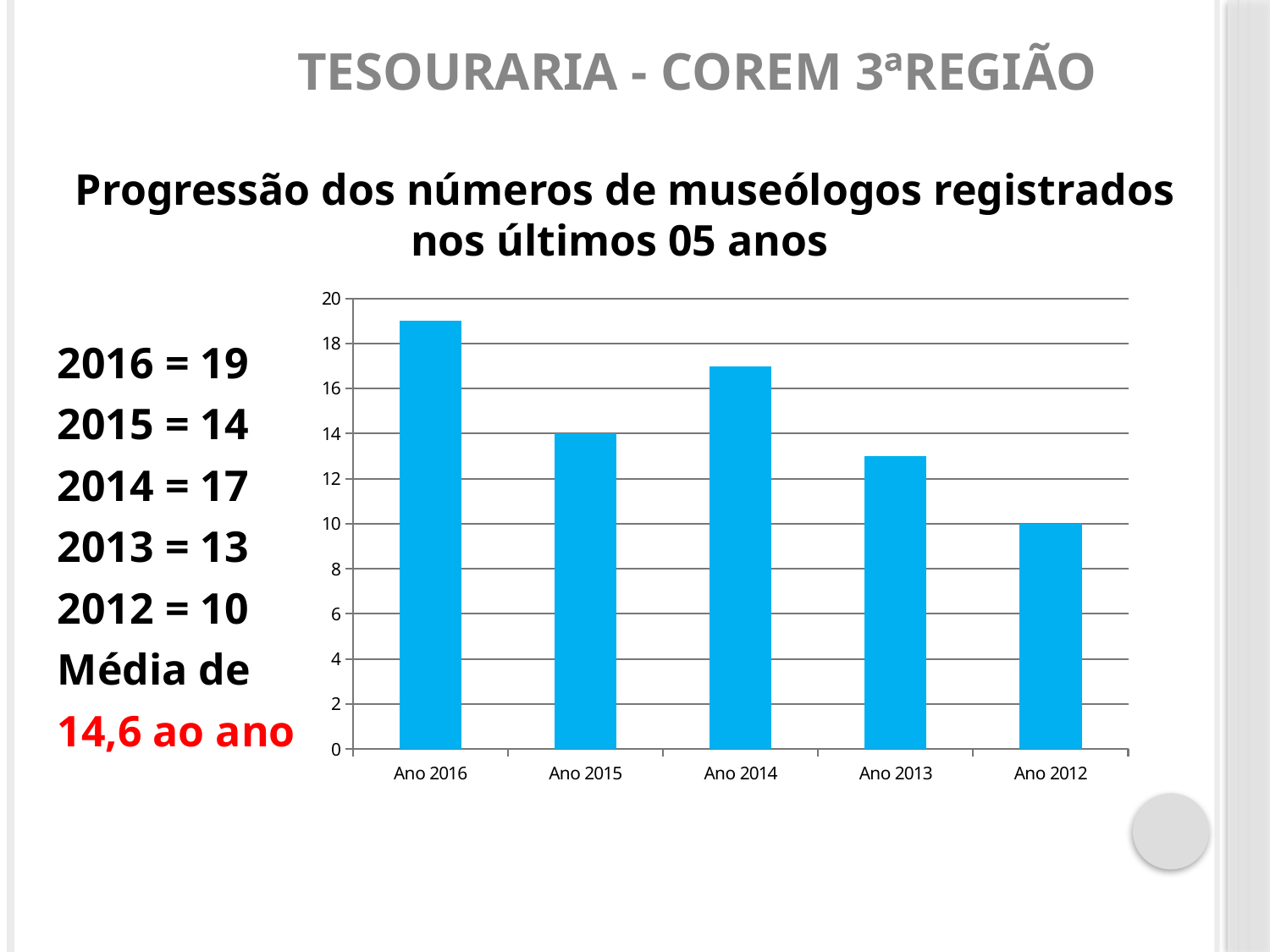
What is the value for Ano 2014? 17 Is the value for Ano 2013 greater or less than 14? less What is the title of the chart? Progressão dos números de museólogos registrados nos últimos 05 anos What is the difference between the values for Ano 2016 and Ano 2012? 9 What kind of chart is shown on the slide? bar chart How many bars (years) does the chart show? 5 Which year has the highest value? Ano 2016 Which is larger, the value for Ano 2015 or the value for Ano 2014? Ano 2014 What is the value for Ano 2012? 10 What is the value for Ano 2016? 19 What is the difference between the values for Ano 2014 and Ano 2013? 4 Which year has the lowest value? Ano 2012